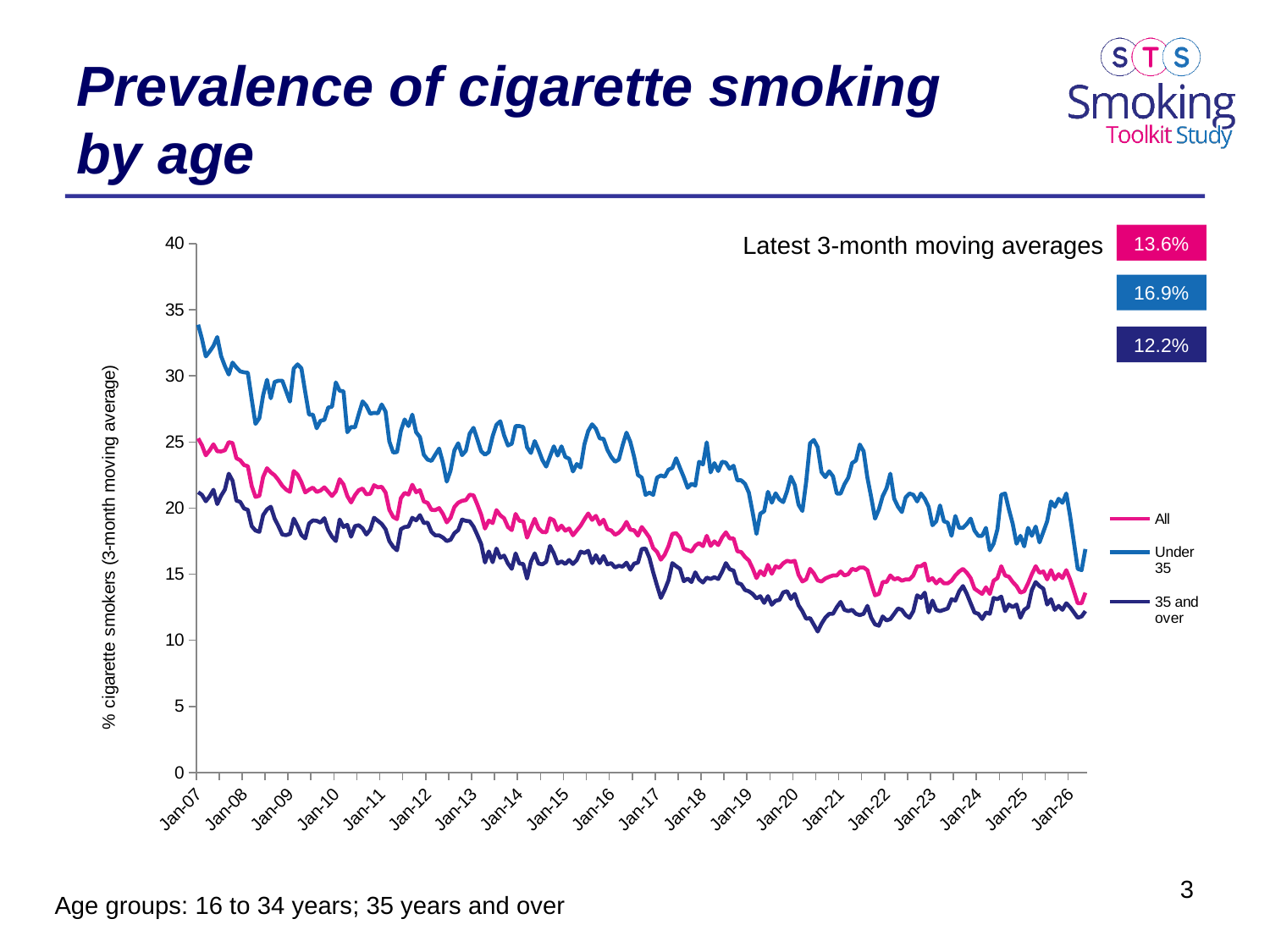
What kind of chart is shown on the slide? Line chart Which is larger in the latest 3-month moving averages: All or 35 and over? All Which series has the highest latest 3-month moving average? Under 35 What is the latest 3-month moving average for the All series? 13.6% Does the Under 35 line rise or fall overall from Jan-07 to Jan-26? Fall What is the label on the y axis? % cigarette smokers (3-month moving average) Is the value for Under 35 at Jan-07 greater or less than 30? greater How many series does the legend list? 3 What is the difference between the latest 3-month moving averages for Under 35 and 35 and over? 4.7 percentage points What is the latest 3-month moving average for the 35 and over group? 12.2% What is the latest 3-month moving average for the Under 35 group? 16.9% Which series has the lowest latest 3-month moving average? 35 and over